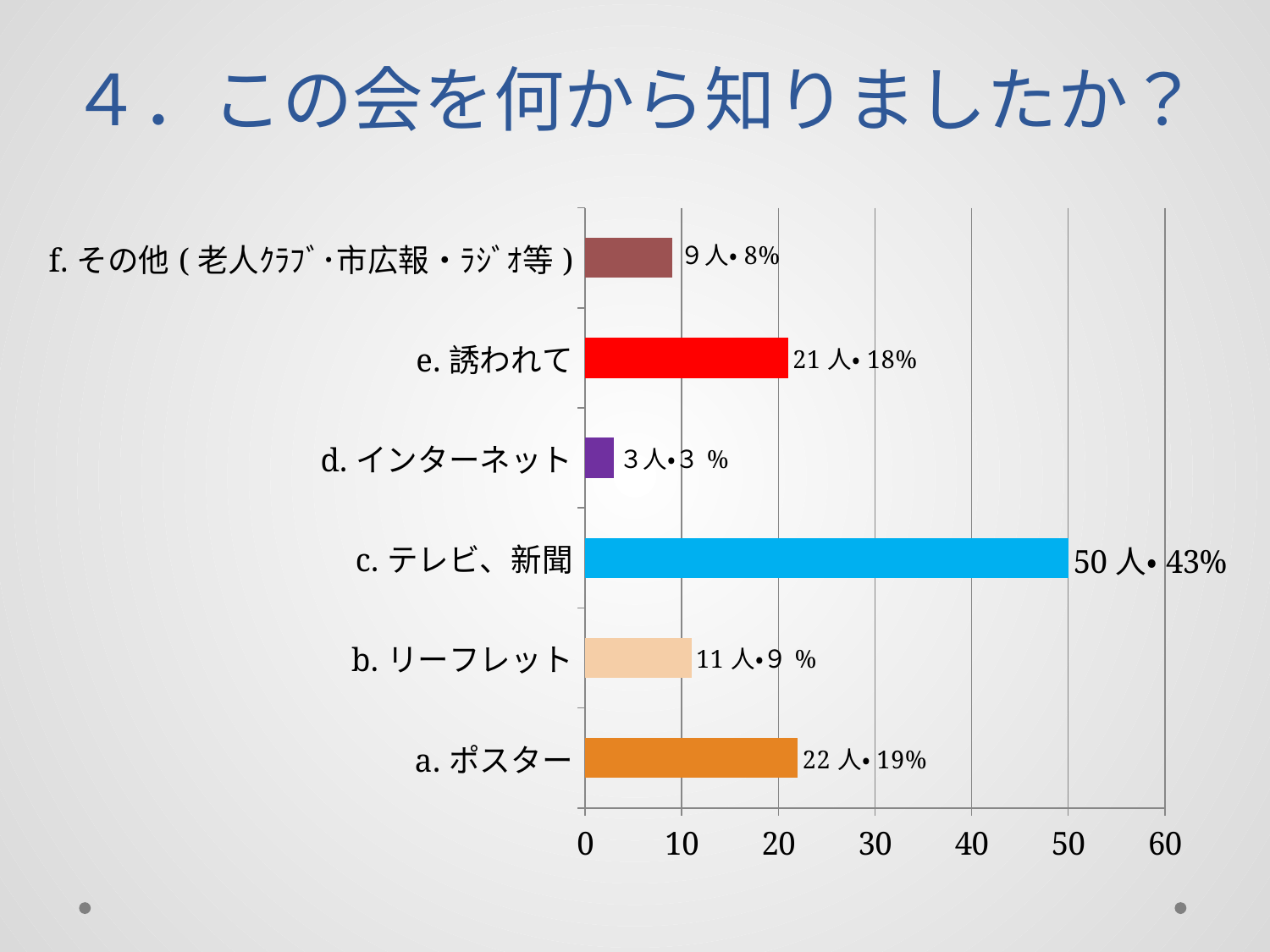
What percentage is shown for e. 誘われて? 18% Which category has the lowest value? d. インターネット Is the value for e. 誘われて greater or less than 20? greater How many categories does the chart show? 6 Which has more people, b. リーフレット or f. その他? b. リーフレット How many people answered c. テレビ、新聞? 50人 What kind of chart is shown on the slide? bar chart How many people answered d. インターネット? 3人 What percentage is shown for a. ポスター? 19% Which category has the highest value? c. テレビ、新聞 What is the title of the slide? ４．この会を何から知りましたか？ What is the difference in number of people between c. テレビ、新聞 and a. ポスター? 28人